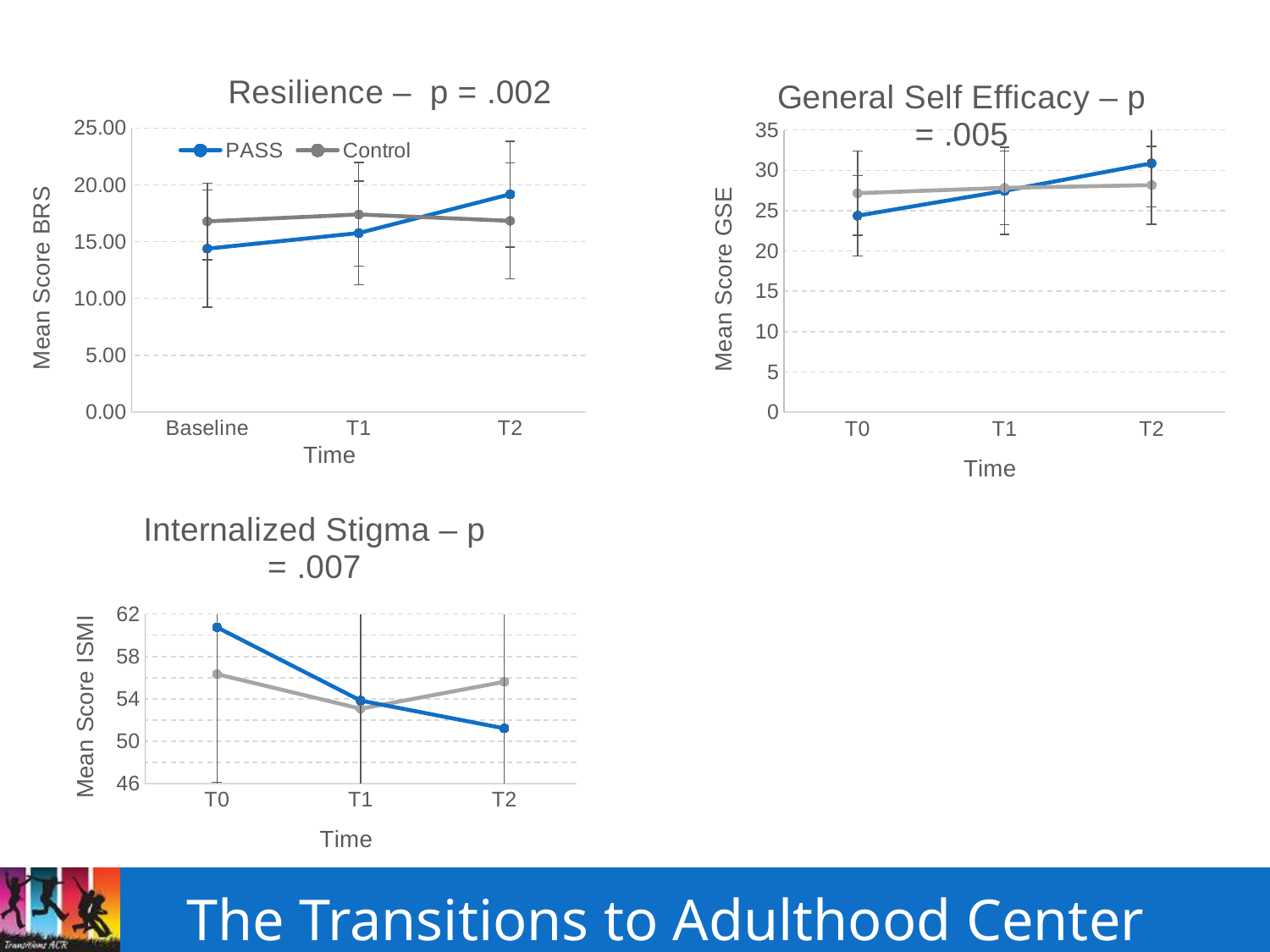
What p-value is given in the title of the Internalized Stigma chart? .007 In the General Self Efficacy chart, is the PASS value at T2 greater or less than 25? greater In the Internalized Stigma chart, does the PASS line rise or fall from T0 to T2? fall In the Resilience chart, how many time points are plotted on the x axis? 3 In the Resilience chart, is the PASS value at T2 greater or less than 15.00? greater In the General Self Efficacy chart, does the PASS line rise or fall from T0 to T2? rise In the Resilience chart, does the PASS line rise or fall from Baseline to T2? rise In the Resilience chart, at Baseline, which series has the higher value, PASS or Control? Control In the Internalized Stigma chart, is the PASS value at T0 greater or less than 58? greater In the Resilience chart, how many series does the legend list? 2 In the Internalized Stigma chart, at T0, which series has the higher value, PASS or Control? PASS In the Resilience chart, what kind of chart is shown? Line chart